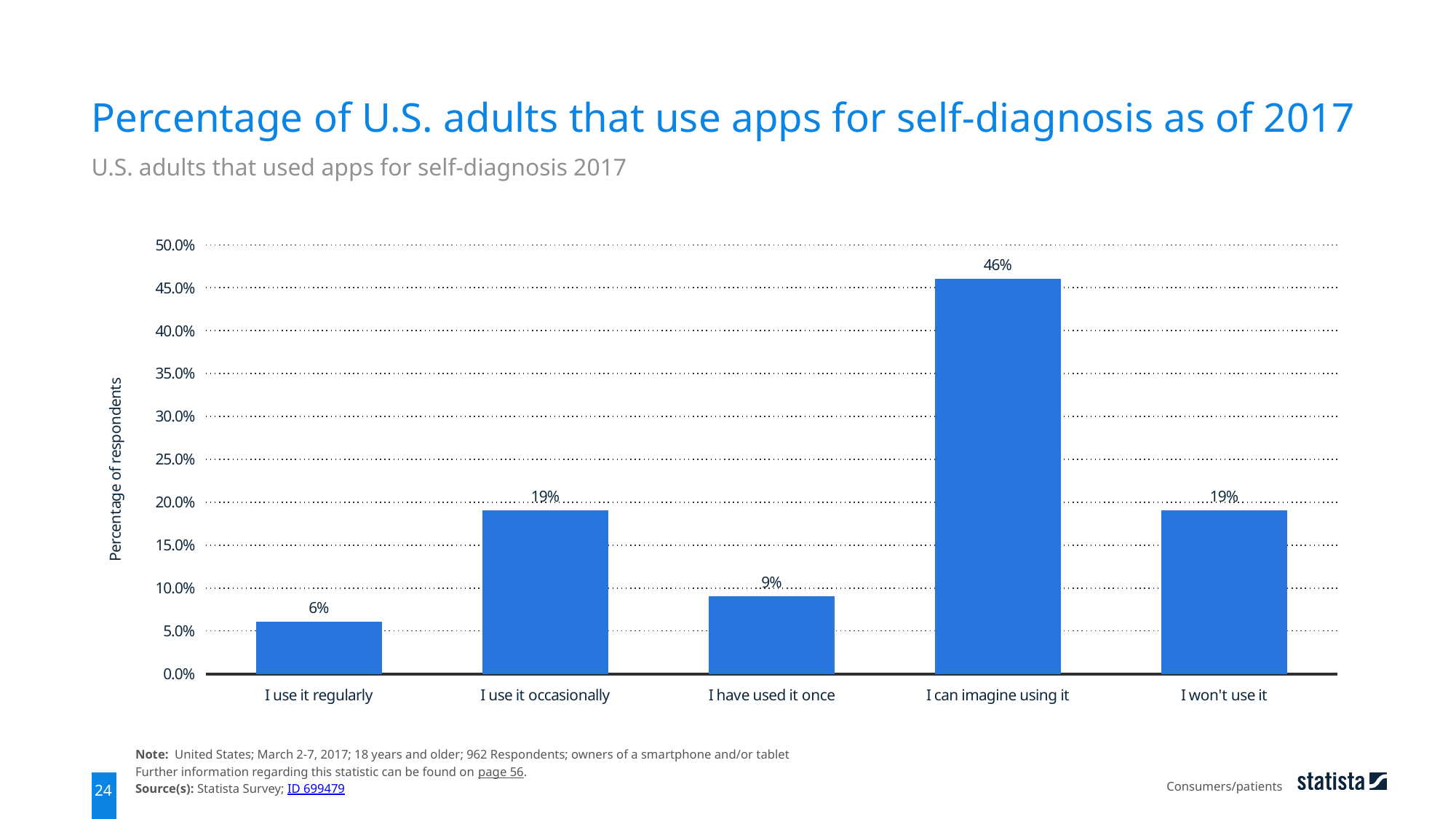
What kind of chart is shown on the slide? Bar chart How many response categories are shown on the x axis? 5 What is the difference in percentage points between "I can imagine using it" and "I won't use it"? 27 What percentage of respondents said "I have used it once"? 9% Is the value for "I can imagine using it" greater or less than 40.0%? greater What percentage of respondents said "I can imagine using it"? 46% Which response category has the lowest percentage of respondents? I use it regularly What is the label of the y axis? Percentage of respondents Which is larger: the value for "I use it occasionally" or the value for "I have used it once"? I use it occasionally What percentage of respondents said "I use it regularly"? 6% Which response category has the highest percentage of respondents? I can imagine using it What is the title of the chart? Percentage of U.S. adults that use apps for self-diagnosis as of 2017